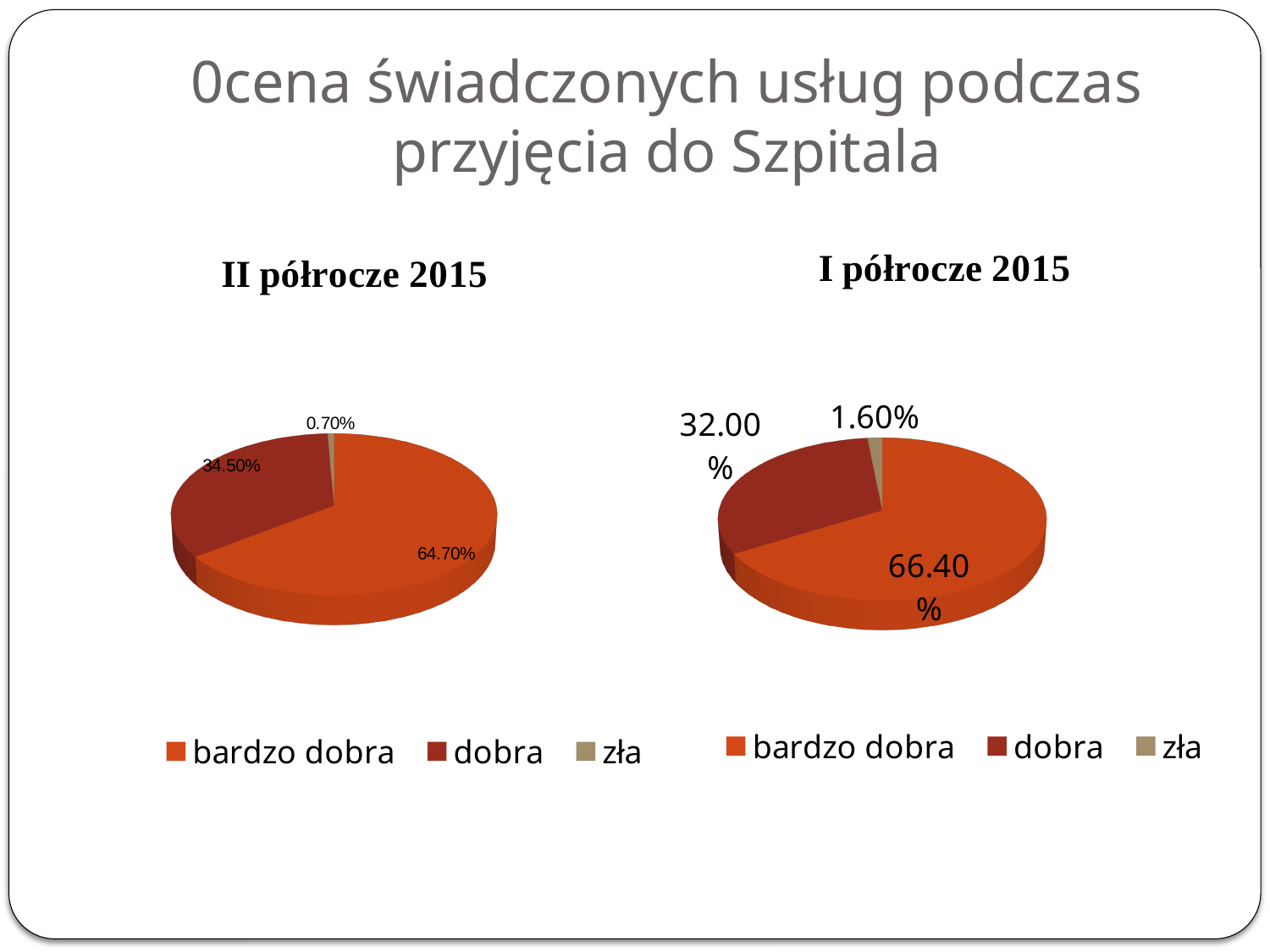
What kind of chart is the "I półrocze 2015" chart? pie chart In the "II półrocze 2015" chart, what is the value for "bardzo dobra"? 64.70% In the "I półrocze 2015" chart, which category has the smallest share? zła In the "II półrocze 2015" chart, what is the value for "zła"? 0.70% Is the value for "dobra" larger in the "II półrocze 2015" chart or in the "I półrocze 2015" chart? II półrocze 2015 In the "II półrocze 2015" chart, what is the value for "dobra"? 34.50% In the "I półrocze 2015" chart, what is the value for "dobra"? 32.00% In the "II półrocze 2015" chart, which category has the largest share? bardzo dobra In the "I półrocze 2015" chart, what is the value for "bardzo dobra"? 66.40% In the "I półrocze 2015" chart, what is the difference between "bardzo dobra" and "dobra"? 34.40% In the "I półrocze 2015" chart, what is the value for "zła"? 1.60% How many categories does the "II półrocze 2015" chart show? 3